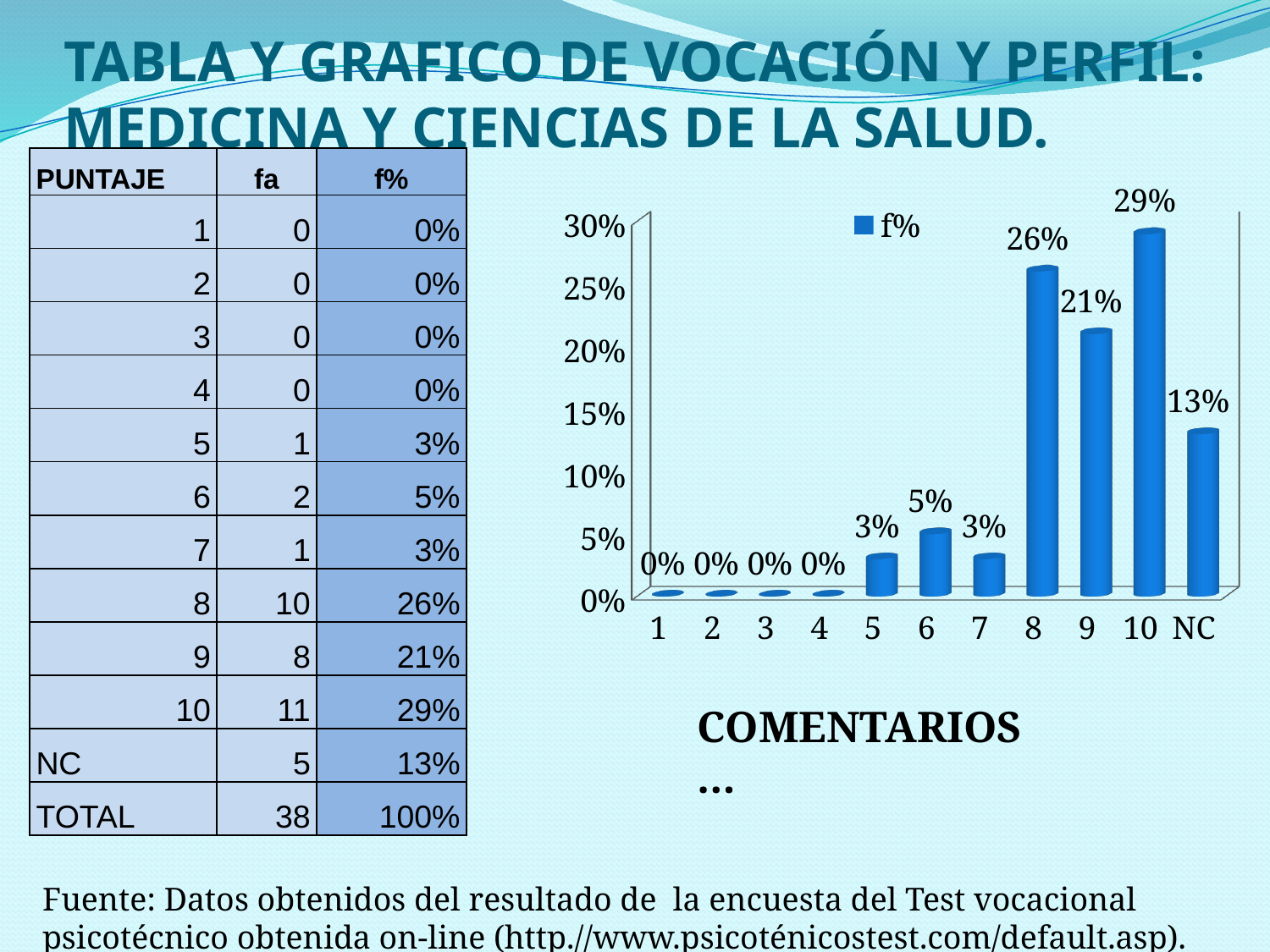
What is the f% value for category 8 in the chart? 26% Which category has the highest f% value in the chart? 10 How many categories are shown on the x axis of the chart? 11 Which has a larger f% value, category 8 or category NC? 8 Is the f% value for category 9 greater or less than 15%? greater What is the difference between the f% values for categories 10 and 9? 8% What is the name of the series shown in the chart legend? f% What is the f% value for category NC in the chart? 13% What is the f% value for category 6 in the chart? 5% How many series does the chart legend list? 1 How many categories in the chart have an f% value of 0%? 4 What kind of chart is shown on the slide? bar chart